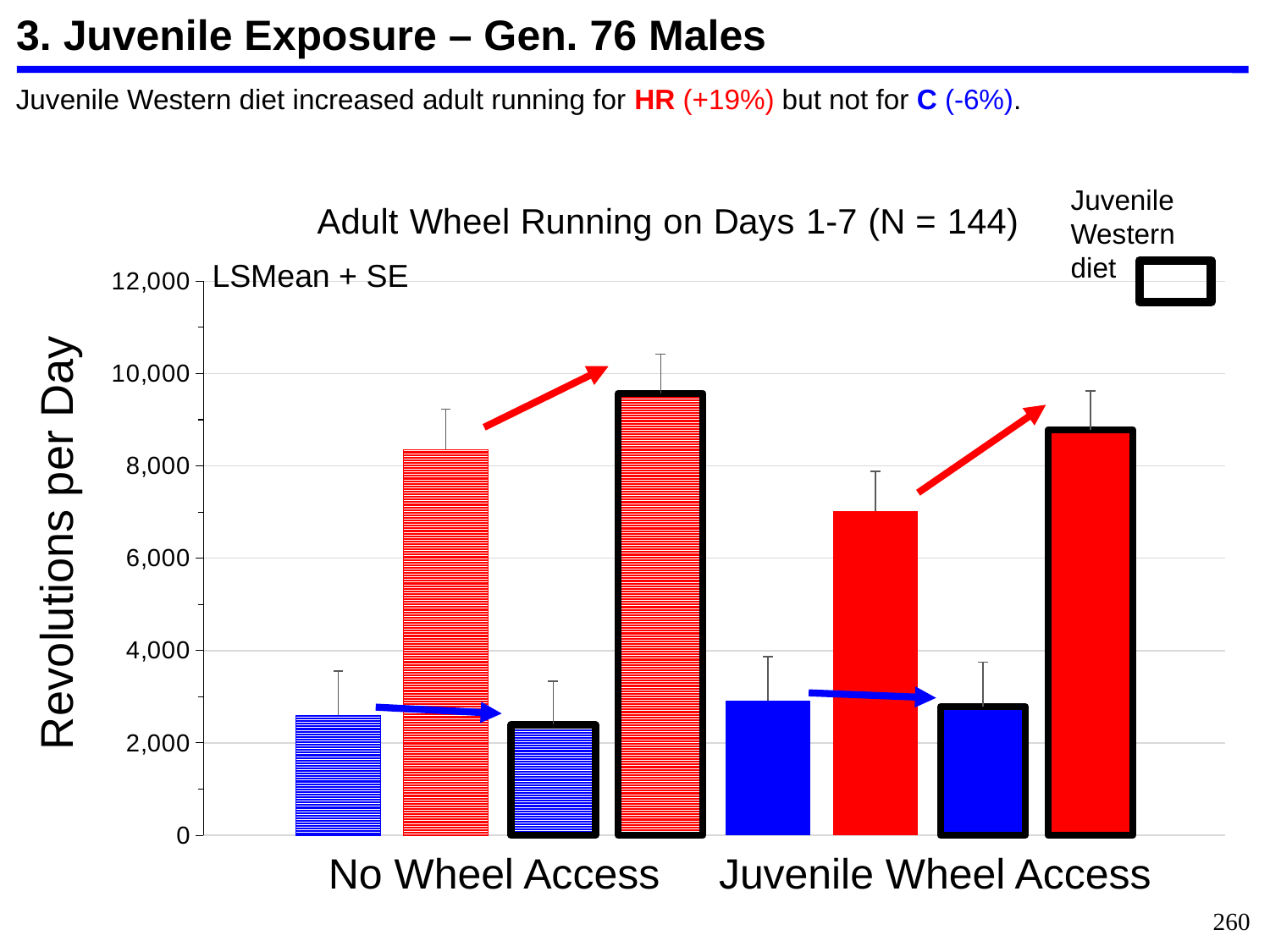
What is the label on the vertical axis of the chart? Revolutions per Day Which bar in the chart is the tallest overall? the red bar with a black outline in the No Wheel Access group Are the red bars or the blue bars higher in the chart? the red bars How many categories are shown along the x axis of the chart? 2 What kind of chart is shown on the slide? bar chart Is the value of the blue bar without a black outline in the No Wheel Access group greater or less than 4,000? less Is the value of the red bar without a black outline in the Juvenile Wheel Access group greater or less than 8,000? less Is the value of the red bar with a black outline in the Juvenile Wheel Access group greater or less than 8,000? greater In the No Wheel Access group, which is larger: the red bar with a black outline or the red bar without an outline? the red bar with a black outline What is the title of the chart? Adult Wheel Running on Days 1-7 (N = 144)